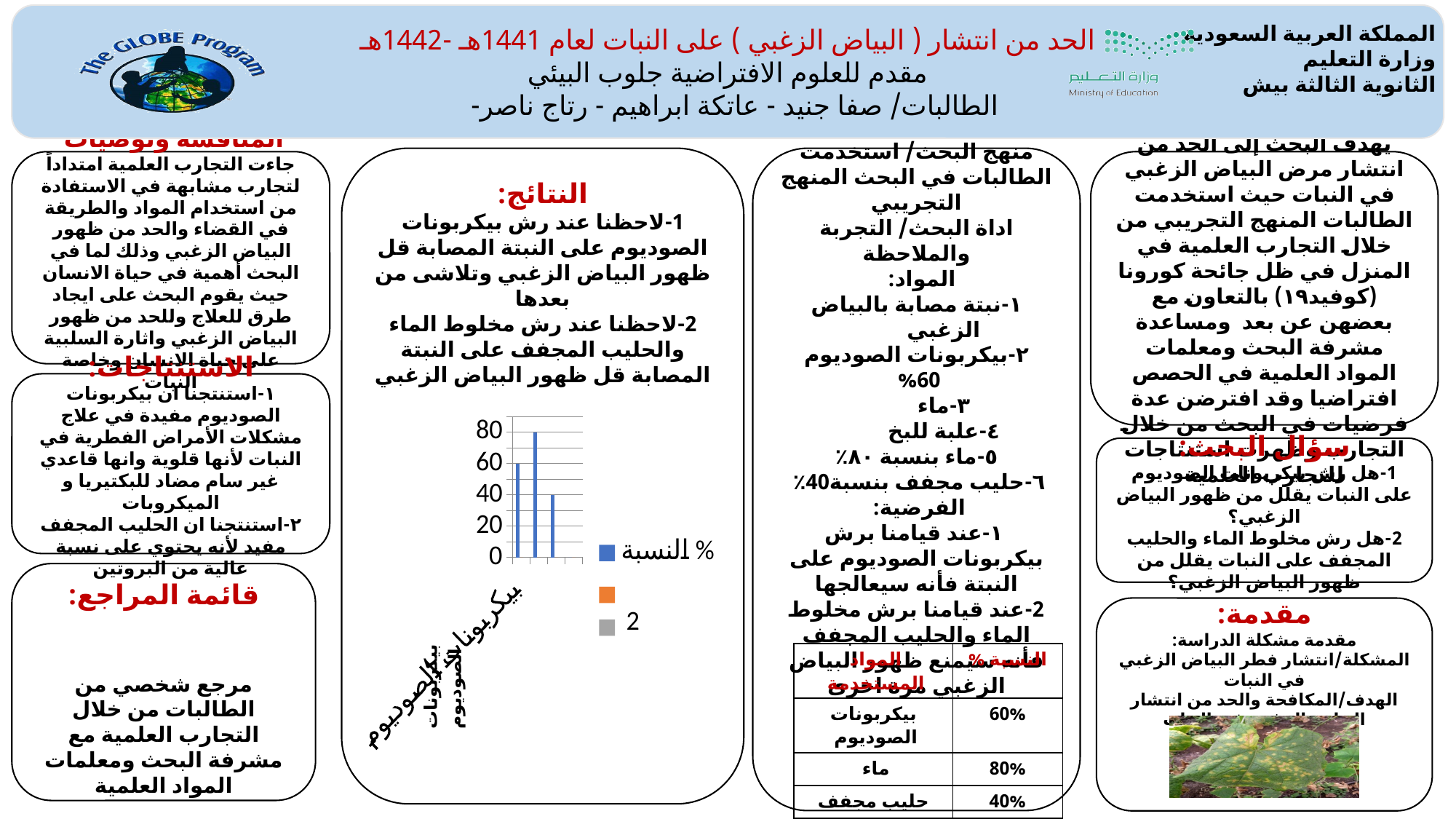
How many entries does the chart's legend list? 3 What is the highest value shown on the chart's vertical axis? 80 What is the value of the shortest bar in the chart? 40 Is the value of the third bar from the left greater or less than 60? less Which bar is the tallest in the chart: the first, second or third from the left? second Is the value of the first bar from the left greater or less than 40? greater What kind of chart is shown on the slide? bar chart What is the label of the first (blue) legend entry in the chart? النسبة % How many bars are plotted in the chart? 3 What is the value of the tallest bar in the chart? 80 Which is larger in the chart: the first bar or the third bar from the left? the first bar Which bar is the shortest in the chart: the first, second or third from the left? third